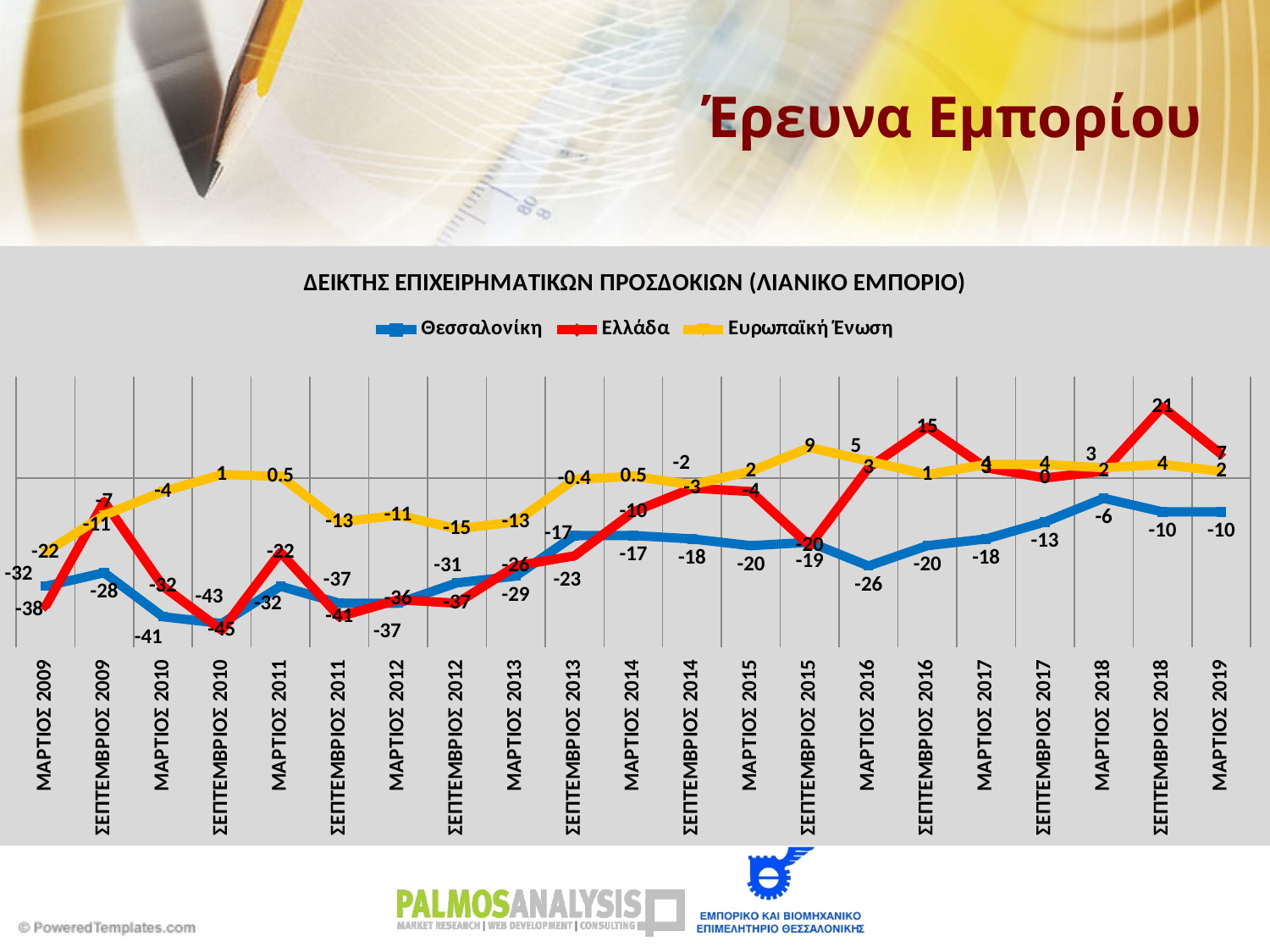
How many time points are plotted along the x axis? 21 What is the value for Ελλάδα in ΣΕΠΤΕΜΒΡΙΟΣ 2018? 21 In which period does the Ευρωπαϊκή Ένωση series reach its highest value? ΣΕΠΤΕΜΒΡΙΟΣ 2015 What type of chart is shown on the slide? line chart In ΜΑΡΤΙΟΣ 2016, which series has the higher value, Ελλάδα or Θεσσαλονίκη? Ελλάδα In which period does the Θεσσαλονίκη series reach its highest value? ΜΑΡΤΙΟΣ 2018 How many series does the legend list? 3 In which period does the Ελλάδα series reach its highest value? ΣΕΠΤΕΜΒΡΙΟΣ 2018 What is the value for Θεσσαλονίκη in ΜΑΡΤΙΟΣ 2016? -26 By how much does the Ελλάδα value fall from ΣΕΠΤΕΜΒΡΙΟΣ 2018 to ΜΑΡΤΙΟΣ 2019? 14 Which colour represents the Ελλάδα series in the legend? red What is the value for Ευρωπαϊκή Ένωση in ΣΕΠΤΕΜΒΡΙΟΣ 2015? 9